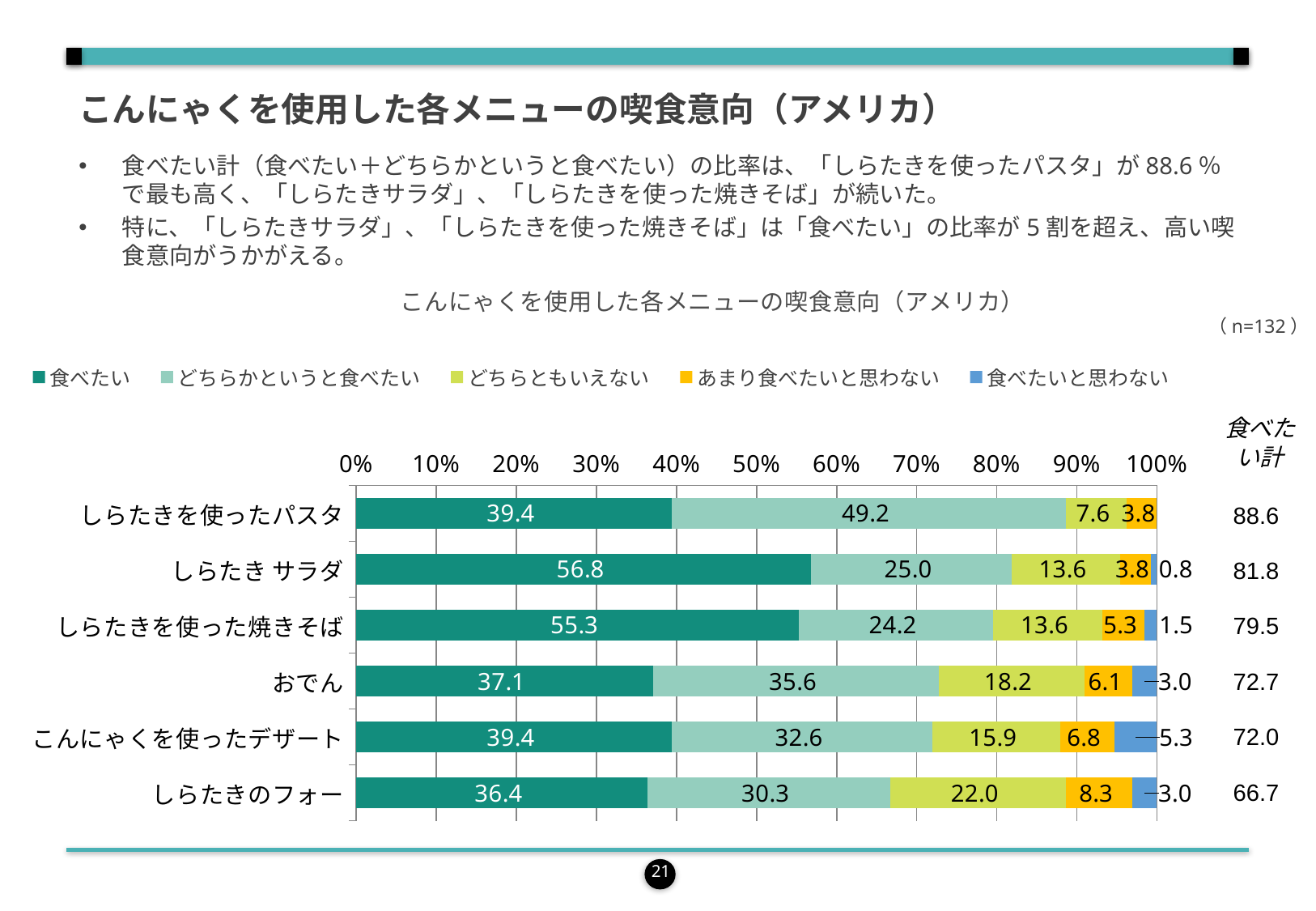
What type of chart is shown on the slide? Stacked bar chart How many series does the legend list? 5 What is the difference between the 食べたい values for しらたき サラダ and おでん? 19.7 How many menu categories are plotted in the chart? 6 What is the 食べたいと思わない value for こんにゃくを使ったデザート? 5.3 Which is larger, the あまり食べたいと思わない value for しらたきのフォー or for おでん? しらたきのフォー What is the どちらともいえない value for しらたきのフォー? 22.0 Which menu has the lowest 食べたい計 value? しらたきのフォー What is the 食べたい value for しらたき サラダ? 56.8 What is the sample size (n) shown for the chart? n=132 Which menu has the highest 食べたい value? しらたき サラダ What is the どちらかというと食べたい value for しらたきを使ったパスタ? 49.2